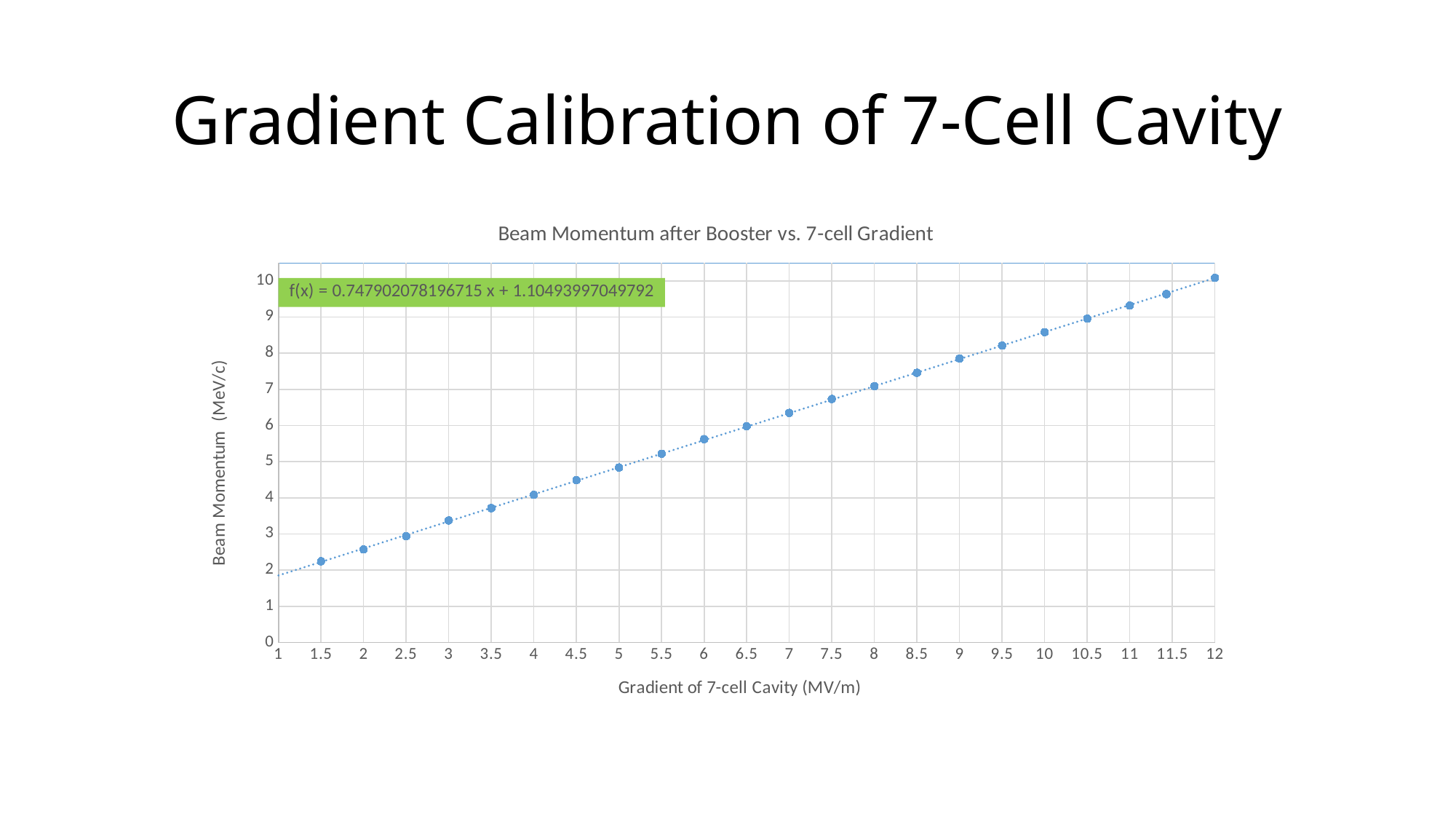
At which gradient value is the beam momentum lowest? 1.5 What is the trendline equation shown on the chart? f(x) = 0.747902078196715 x + 1.10493997049792 Is the beam momentum at a gradient of 6 greater or less than 5? greater What is the title of the chart? Beam Momentum after Booster vs. 7-cell Gradient Is the beam momentum at a gradient of 10 greater or less than 9? less Is the beam momentum at a gradient of 8 greater or less than 8? less How many data points are plotted on the chart? 22 Which has the larger beam momentum: a gradient of 4 or a gradient of 9? 9 At which gradient value is the beam momentum highest? 12 Do the beam momentum values rise or fall as the gradient increases along the x axis? Rise What kind of chart is shown on the slide? Scatter chart